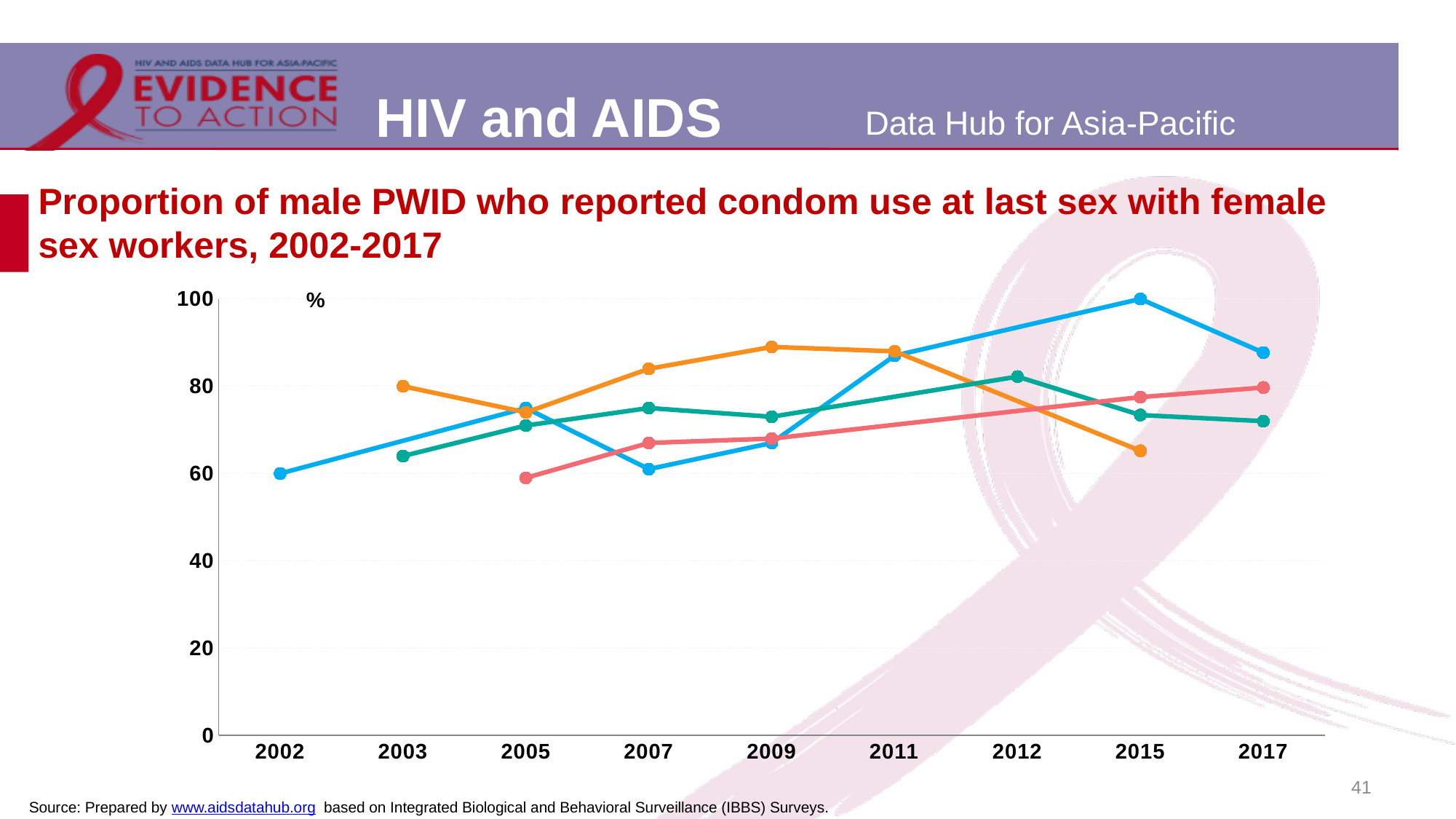
Is the value of the orange line in 2009 greater or less than 80? greater Is the value of the orange line in 2015 greater or less than 80? less In which year does the blue line reach its highest value? 2015 Is the value of the blue line in 2007 greater or less than 80? less In 2015, which line has the larger value, the blue line or the orange line? blue line What is the title of the chart on the slide? Proportion of male PWID who reported condom use at last sex with female sex workers, 2002-2017 How many years are shown on the x axis of the chart? 9 What kind of chart is shown on the slide? line chart What is the value of the blue line in 2002? 60 Does the pink line rise or fall from 2005 to 2017? rise What unit is shown on the y axis of the chart? % What is the value of the blue line in 2015? 100